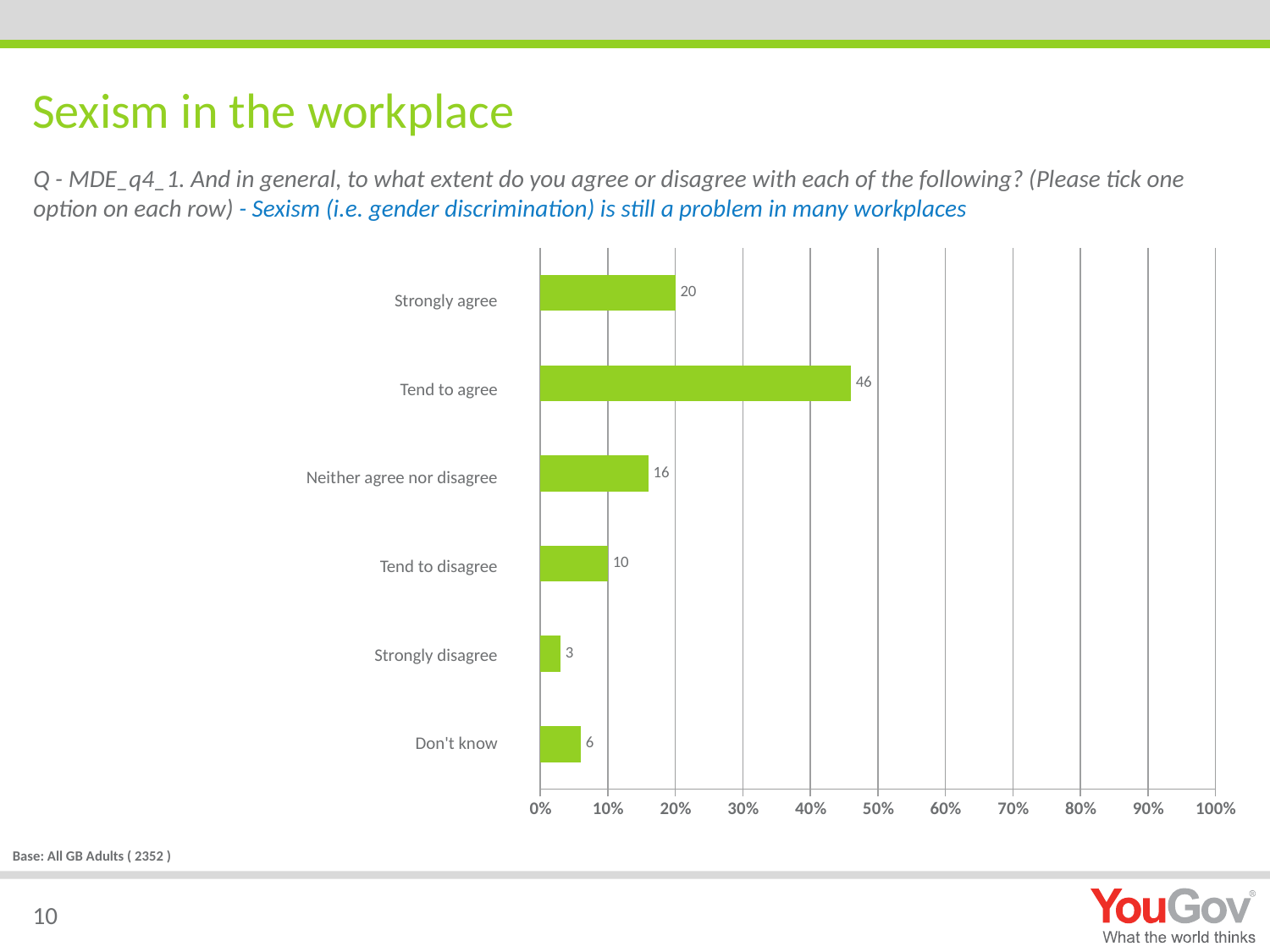
Which category has the lowest value? Strongly disagree Which category has the highest value? Tend to agree What is the value for "Neither agree nor disagree"? 16 What is the value for "Tend to agree"? 46 What is the value for "Don't know"? 6 What is the difference between the values for "Tend to agree" and "Strongly agree"? 26 What is the value for "Strongly agree"? 20 How many categories are shown in the chart? 6 Which is larger, the value for "Tend to disagree" or the value for "Don't know"? Tend to disagree What kind of chart is shown on the slide? Bar chart What is the base stated below the chart? All GB Adults ( 2352 ) Is the value for "Tend to agree" greater or less than 40%? greater